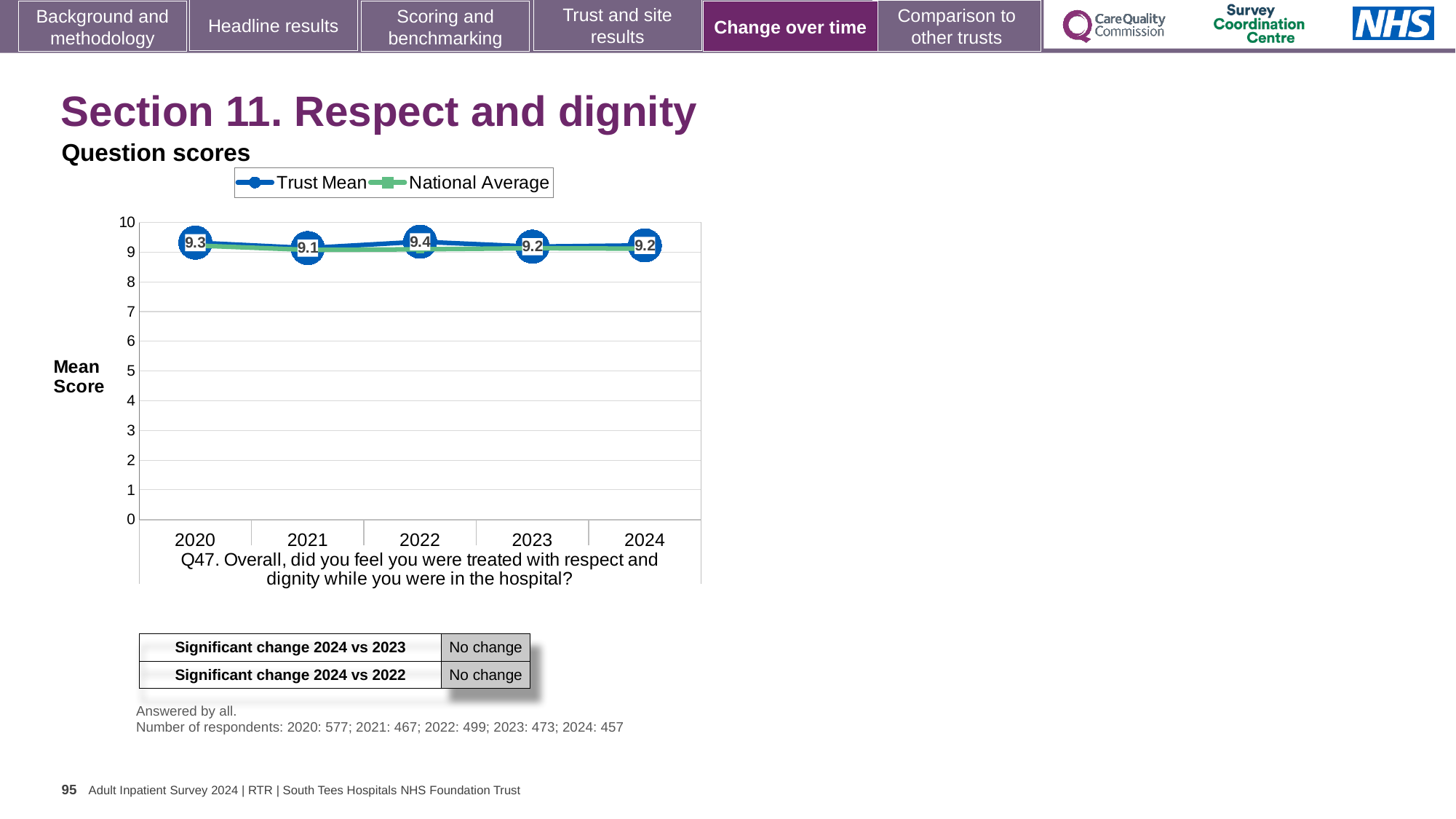
What is the difference between the Trust Mean in 2022 and in 2021? 0.3 In which year is the Trust Mean highest? 2022 How many series does the legend list? 2 What is the Trust Mean score for 2021? 9.1 How many years are plotted on the x axis? 5 What is the Trust Mean score for 2024? 9.2 What kind of chart is shown? line chart In which year is the Trust Mean lowest? 2021 Which year has the larger Trust Mean, 2020 or 2021? 2020 Does the Trust Mean rise or fall from 2021 to 2022? rise What is the Trust Mean score for 2022? 9.4 Is the National Average value for 2020 greater or less than 8? greater